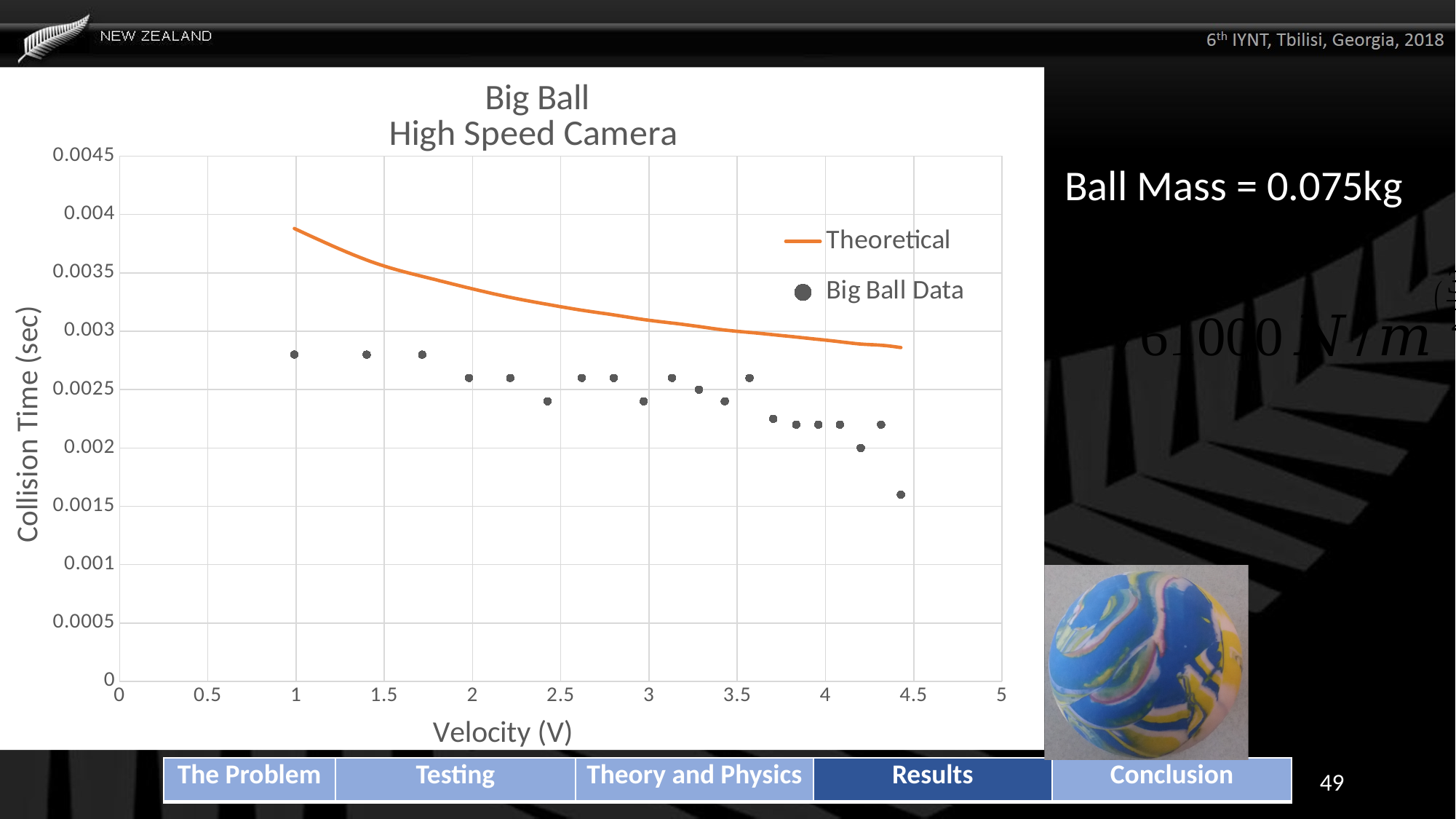
Do the Big Ball Data points generally rise or fall as velocity increases? Fall Is the Big Ball Data value at a velocity of 1 greater or less than 0.003? less How many series does the chart legend list? 2 Is the Theoretical value at a velocity of 1 greater or less than 0.0035? greater Is the Theoretical value at a velocity of 4 greater or less than 0.0025? greater What kind of chart is shown on the slide? Scatter chart What are the two series named in the legend? Theoretical and Big Ball Data What is the title of the chart? Big Ball High Speed Camera Which Big Ball Data point has the lowest collision time: the one at the lowest velocity or the one at the highest velocity? The one at the highest velocity At a velocity of 1, which is larger: the Theoretical value or the Big Ball Data value? Theoretical Does the Theoretical curve rise or fall as velocity increases? Fall